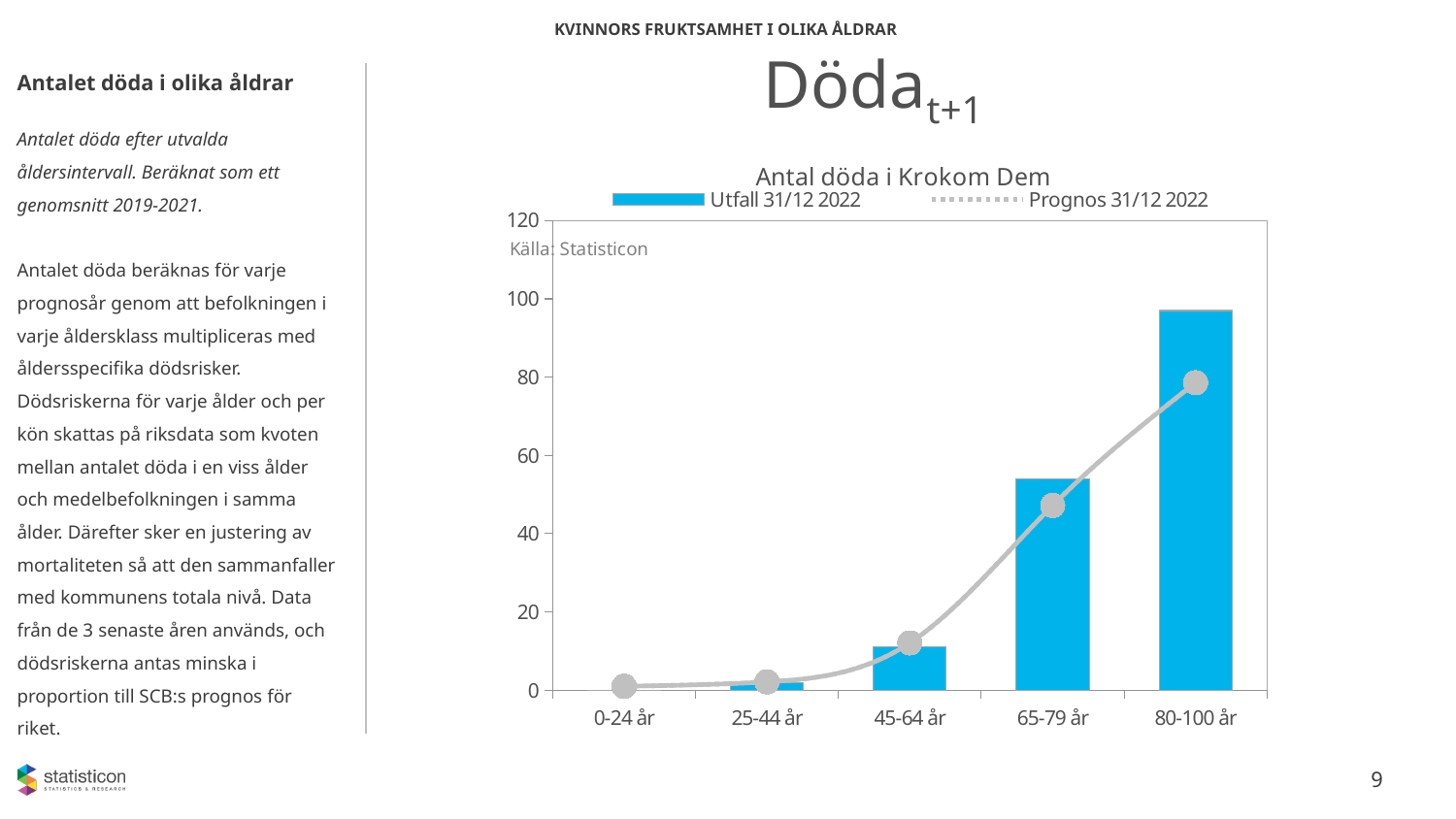
What source is cited on the chart? Statisticon What kind of chart is 'Antal döda i Krokom Dem'? bar chart with a line Is the Utfall 31/12 2022 value for 45-64 år greater or less than 20? less How many age categories are shown on the x axis of the chart? 5 Is the Utfall 31/12 2022 value for 65-79 år greater or less than 60? less For 80-100 år, which is larger: the Utfall 31/12 2022 bar or the Prognos 31/12 2022 point? Utfall 31/12 2022 Is the Utfall 31/12 2022 value for 80-100 år greater or less than 80? greater Do the Utfall 31/12 2022 bars rise or fall from 0-24 år to 80-100 år? rise How many series does the legend of the chart list? 2 Which age group has the highest bar for Utfall 31/12 2022? 80-100 år Which age group has the lowest bar for Utfall 31/12 2022? 0-24 år